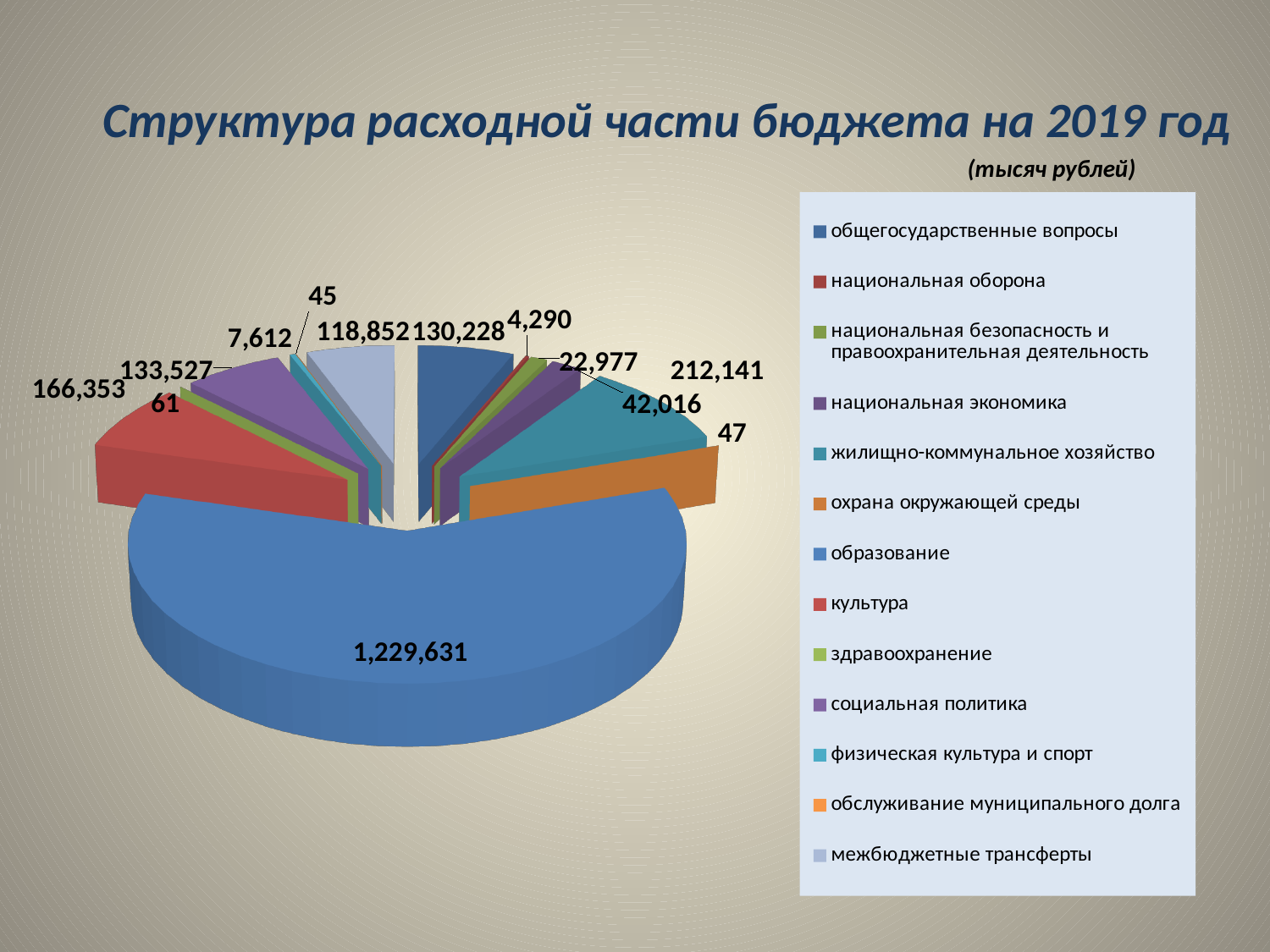
Which category has the largest slice? образование In what units are the values on the chart given? тысяч рублей What is the value for общегосударственные вопросы? 130,228 What is the value for жилищно-коммунальное хозяйство? 212,141 What is the value for физическая культура и спорт? 7,612 Which is larger, культура or социальная политика? культура What is the difference between жилищно-коммунальное хозяйство and культура? 45,788 What is the value for образование? 1,229,631 Which category has the smallest value? обслуживание муниципального долга What is the value for культура? 166,353 How many categories does the pie chart have? 13 What kind of chart is shown on the slide? pie chart